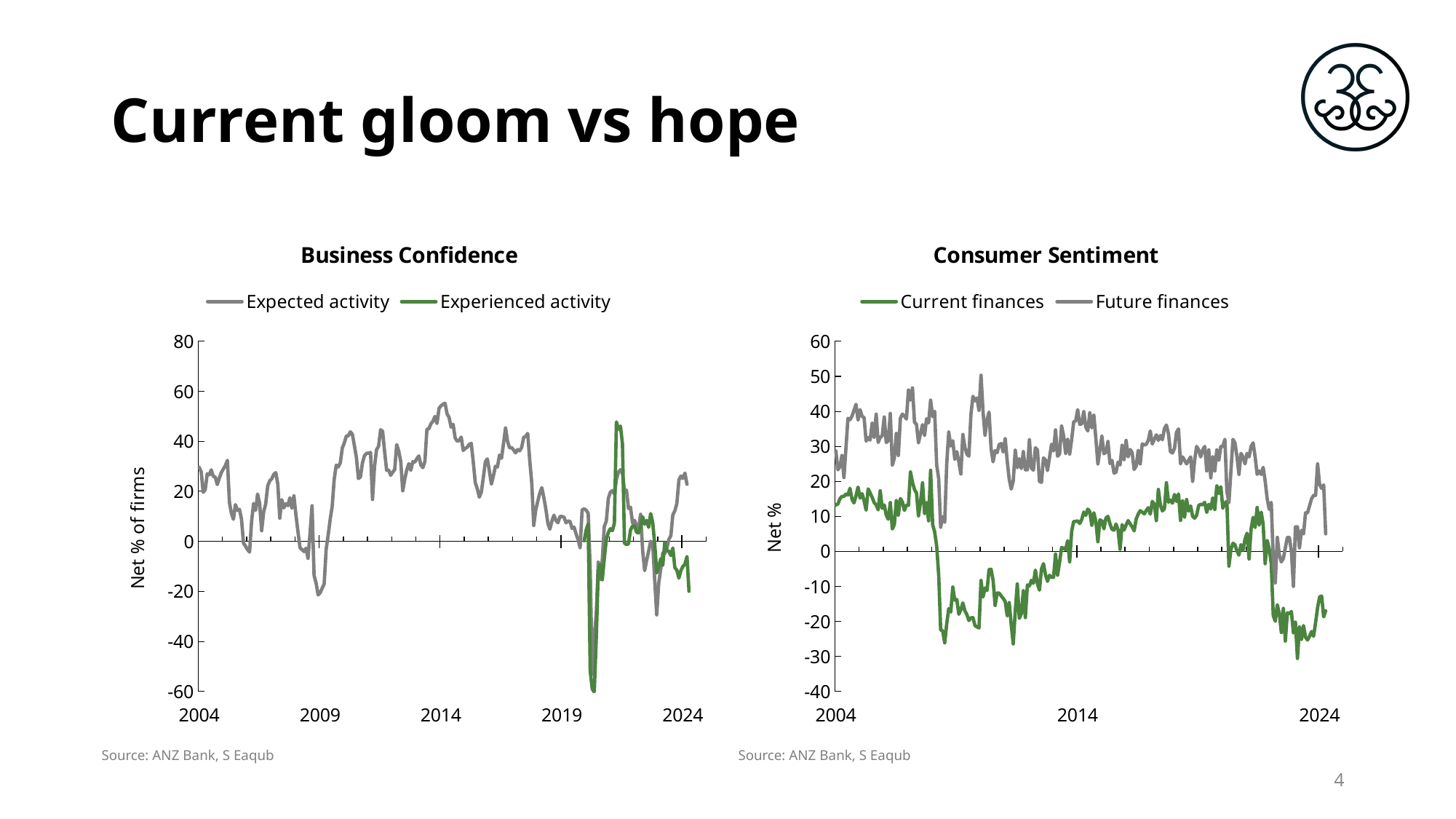
In the Consumer Sentiment chart, is the value of Current finances in 2024 greater or less than -10? less In the Consumer Sentiment chart, which series is higher for most of the period, Current finances or Future finances? Future finances What is the y-axis title of the Business Confidence chart? Net % of firms In the Consumer Sentiment chart, is the value of Current finances in 2009 greater or less than 0? less In the Consumer Sentiment chart, does Current finances rise or fall between 2014 and 2019? rise In the Business Confidence chart, is the value of Expected activity in 2009 greater or less than 0? less In the Business Confidence chart, which series reaches the lowest value shown? Experienced activity How many series does the legend of the Consumer Sentiment chart list? 2 What type of chart is the Business Confidence chart? line chart What are the two series in the legend of the Business Confidence chart? Expected activity and Experienced activity